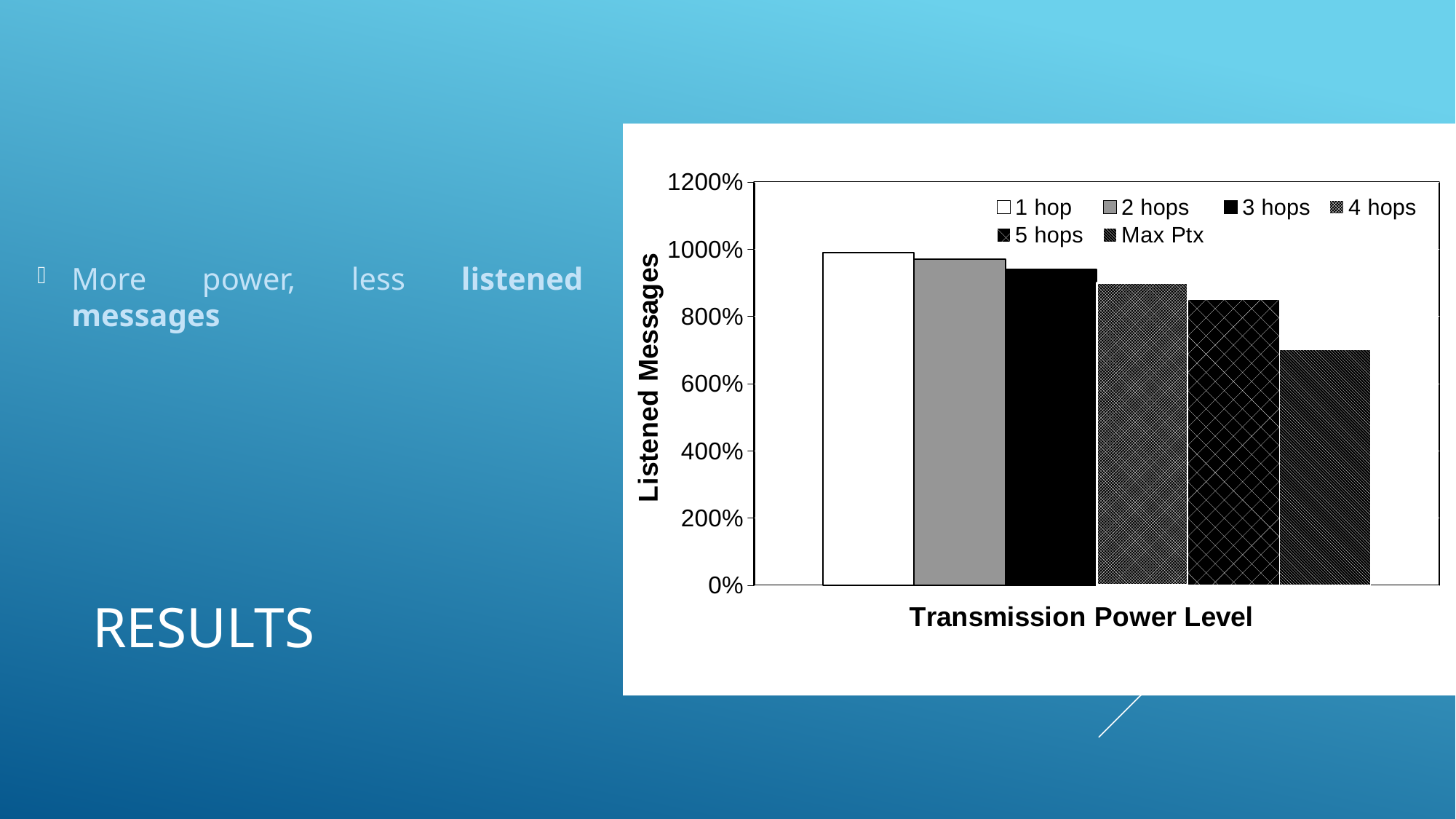
What is the title of the vertical axis? Listened Messages Which series has the highest value for Listened Messages? 1 hop Do the bar values rise or fall from left to right across the chart? fall Which is larger, the value for 3 hops or the value for 5 hops? 3 hops Is the value for Max Ptx greater or less than 800%? less What kind of chart is shown on the slide? bar chart Which series has the lowest value for Listened Messages? Max Ptx How many bars are plotted in the chart? 6 How many series does the legend list? 6 Which is larger, the value for Max Ptx or the value for 2 hops? 2 hops Is the value for 5 hops greater or less than 800%? greater